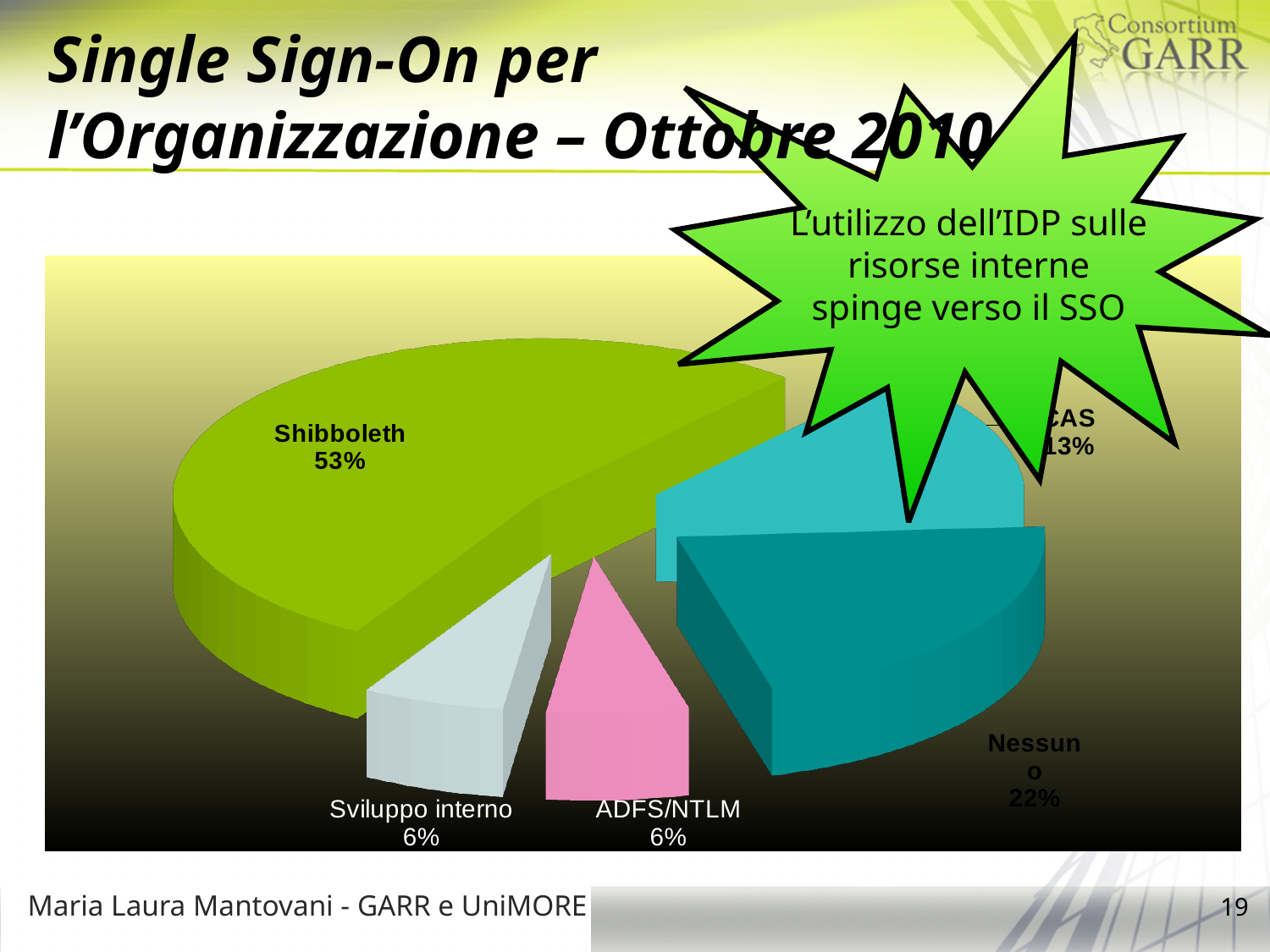
What is the difference in percentage points between Shibboleth and Nessuno? 31 What colour is the Shibboleth slice? green How many slices does the pie chart have? 5 What percentage is shown for Sviluppo interno? 6% What percentage is shown for Nessuno? 22% What is the difference in percentage points between Nessuno and ADFS/NTLM? 16 What share of the pie does Shibboleth have? 53% What colour is the ADFS/NTLM slice? pink What percentage is shown for ADFS/NTLM? 6% What type of chart is shown on the slide? pie chart Which slice of the pie is the largest? Shibboleth Which is larger, the share for Nessuno or the share for Sviluppo interno? Nessuno